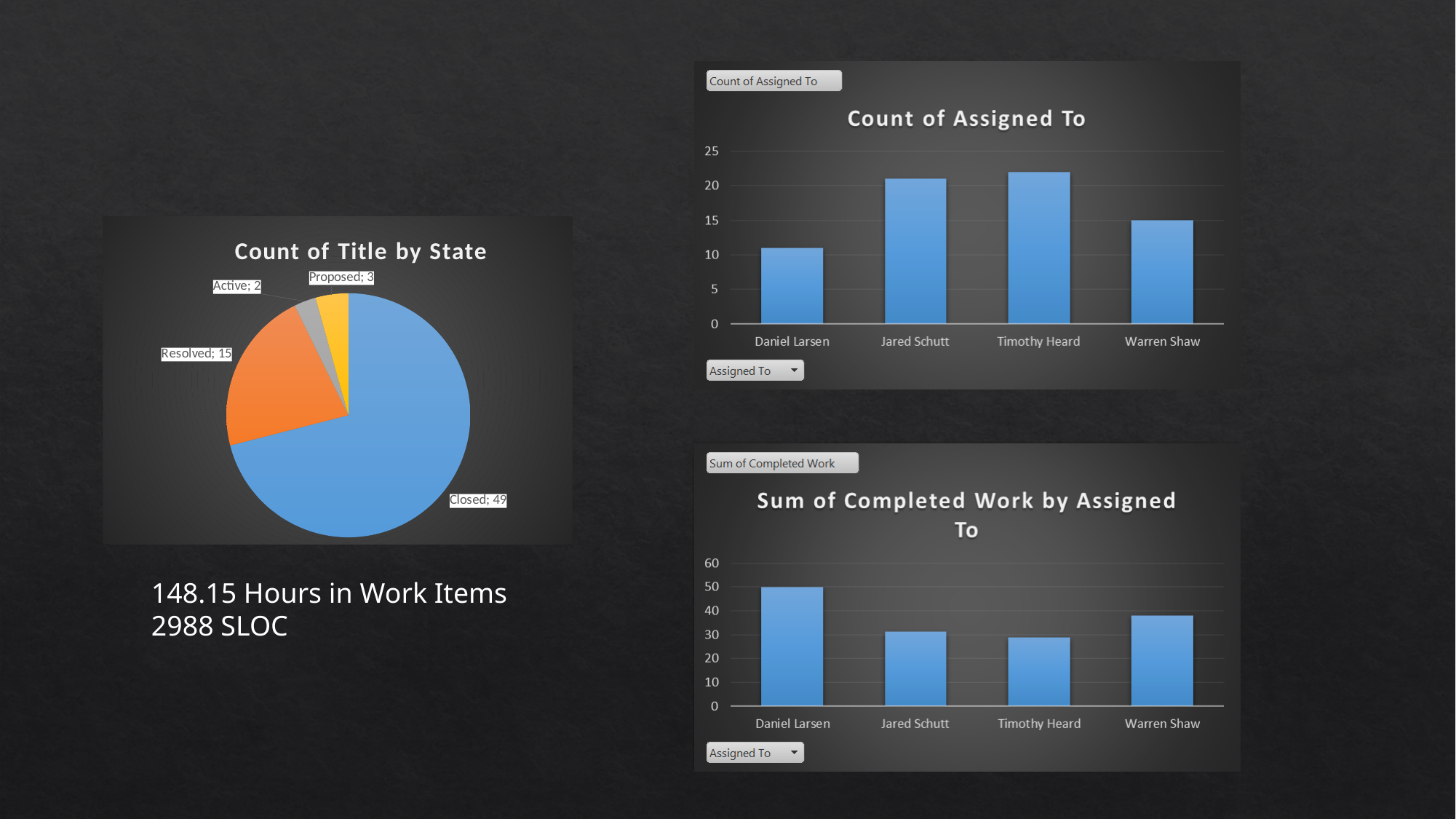
In the 'Count of Assigned To' chart, is the value for Daniel Larsen greater or less than 10? greater How many slices does the 'Count of Title by State' pie chart have? 4 In the 'Count of Title by State' pie chart, which state has the largest slice? Closed In the 'Sum of Completed Work by Assigned To' chart, who has the highest value? Daniel Larsen In the 'Sum of Completed Work by Assigned To' chart, which is larger: Warren Shaw or Jared Schutt? Warren Shaw In the 'Sum of Completed Work by Assigned To' chart, what is the value for Daniel Larsen? 50 In the 'Count of Title by State' pie chart, what is the difference between the Closed and Resolved counts? 34 In the 'Count of Title by State' pie chart, which state has the smallest slice? Active In the 'Count of Assigned To' chart, who has the lowest count? Daniel Larsen In the 'Count of Title by State' pie chart, what is the count for Resolved? 15 In the 'Count of Title by State' pie chart, what is the count for Closed? 49 In the 'Count of Assigned To' chart, what is the value for Warren Shaw? 15